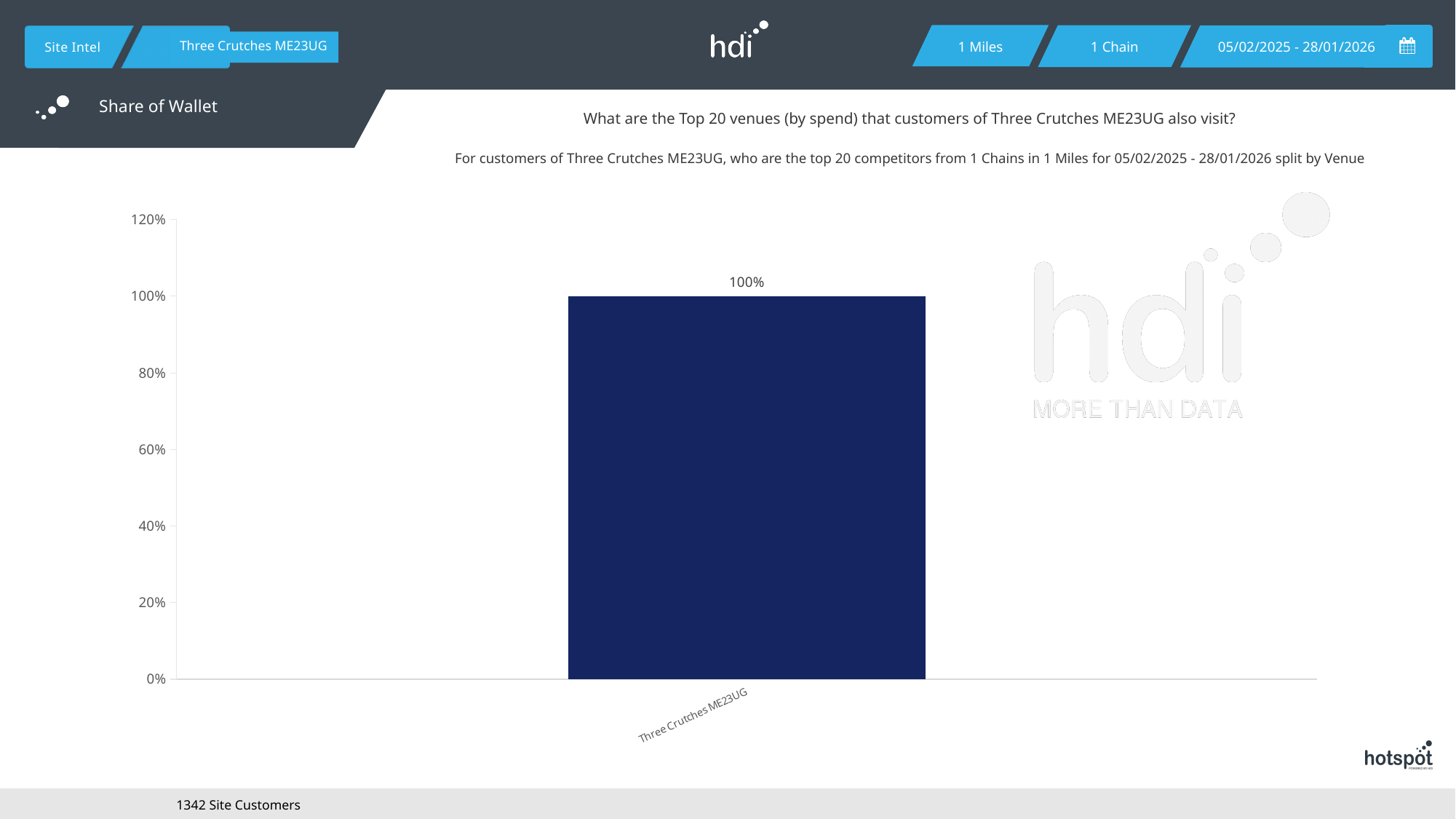
Is the value for Three Crutches ME23UG greater or less than 120%? less What is the value for Three Crutches ME23UG? 100% Which venue has the highest value on the chart? Three Crutches ME23UG What kind of chart is shown on the slide? bar chart How many venues are plotted on the chart? 1 Is the value for Three Crutches ME23UG greater or less than 80%? greater What is the name of the only venue shown on the x axis? Three Crutches ME23UG What is the highest value shown on the y axis? 120%